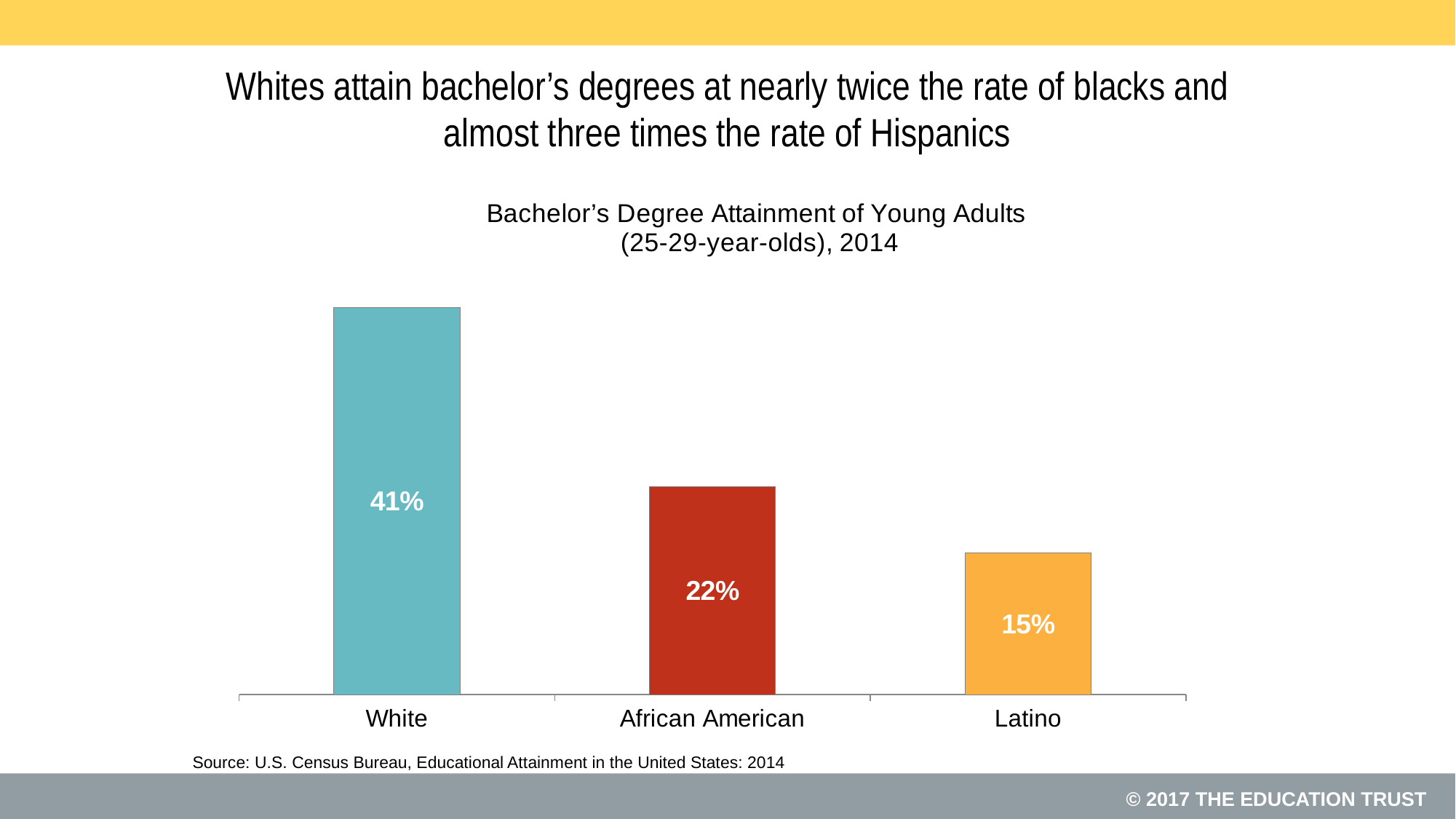
What is the difference in percentage points between the African American and Latino attainment rates? 7 percentage points What type of chart is shown on the slide? Bar chart What is the difference in percentage points between the White and African American attainment rates? 19 percentage points Which group has a higher attainment rate, African American or Latino? African American How many groups are shown in the chart? 3 Which group has the lowest bachelor's degree attainment rate? Latino What is the title of the chart? Bachelor's Degree Attainment of Young Adults (25-29-year-olds), 2014 What is the bachelor's degree attainment rate for African American young adults? 22% Which group has the highest bachelor's degree attainment rate? White What is the bachelor's degree attainment rate for Latino young adults? 15% Do the values rise or fall moving from left to right across the chart? Fall What is the bachelor's degree attainment rate for White young adults? 41%